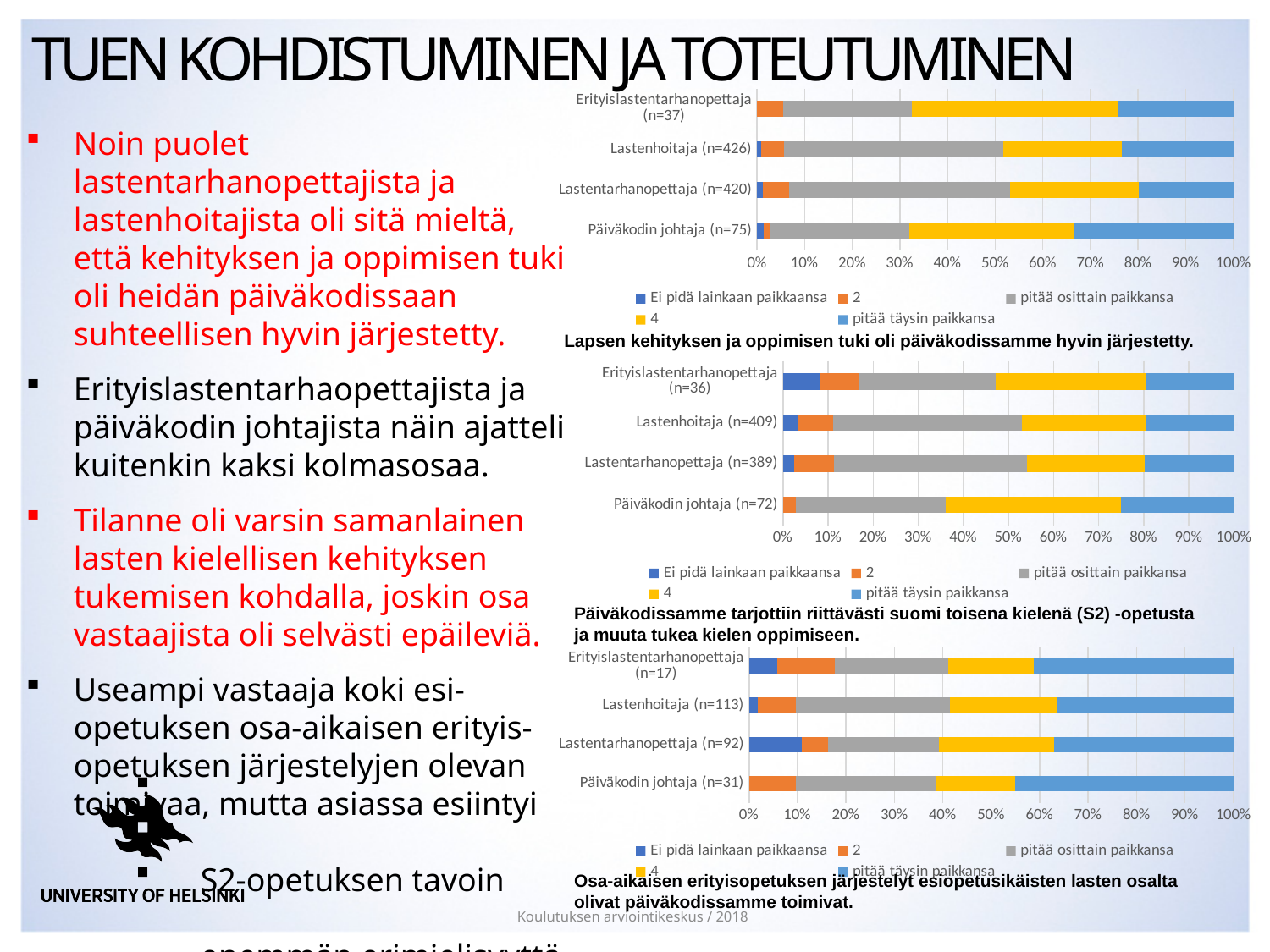
What kind of chart is used for the chart captioned "Lapsen kehityksen ja oppimisen tuki oli päiväkodissamme hyvin järjestetty."? Stacked bar chart In the bottom chart ("Osa-aikaisen erityisopetuksen järjestelyt..."), what is the category label of the bar with n=17? Erityislastentarhanopettaja (n=17) In the bottom chart ("Osa-aikaisen erityisopetuksen järjestelyt..."), which has the larger "Ei pidä lainkaan paikkaansa" segment: Lastentarhanopettaja (n=92) or Lastenhoitaja (n=113)? Lastentarhanopettaja (n=92) In the top chart ("Lapsen kehityksen ja oppimisen tuki..."), which category has the largest "pitää täysin paikkansa" segment? Päiväkodin johtaja (n=75) In the middle chart ("Päiväkodissamme tarjottiin riittävästi suomi toisena kielenä (S2) -opetusta..."), is the "Ei pidä lainkaan paikkaansa" segment for Lastenhoitaja (n=409) greater or less than 10%? less In the top chart ("Lapsen kehityksen ja oppimisen tuki..."), which legend entry is shown in grey? pitää osittain paikkansa In the bottom chart ("Osa-aikaisen erityisopetuksen järjestelyt..."), is the "pitää täysin paikkansa" segment for Päiväkodin johtaja (n=31) greater or less than 40%? greater In the top chart ("Lapsen kehityksen ja oppimisen tuki..."), how many respondent categories are plotted? 4 How many charts are shown on the slide? 3 In the top chart ("Lapsen kehityksen ja oppimisen tuki..."), is the "pitää osittain paikkansa" segment for Lastenhoitaja (n=426) greater or less than 40%? greater How many series does the legend of the middle chart ("Päiväkodissamme tarjottiin riittävästi suomi toisena kielenä (S2) -opetusta...") list? 5